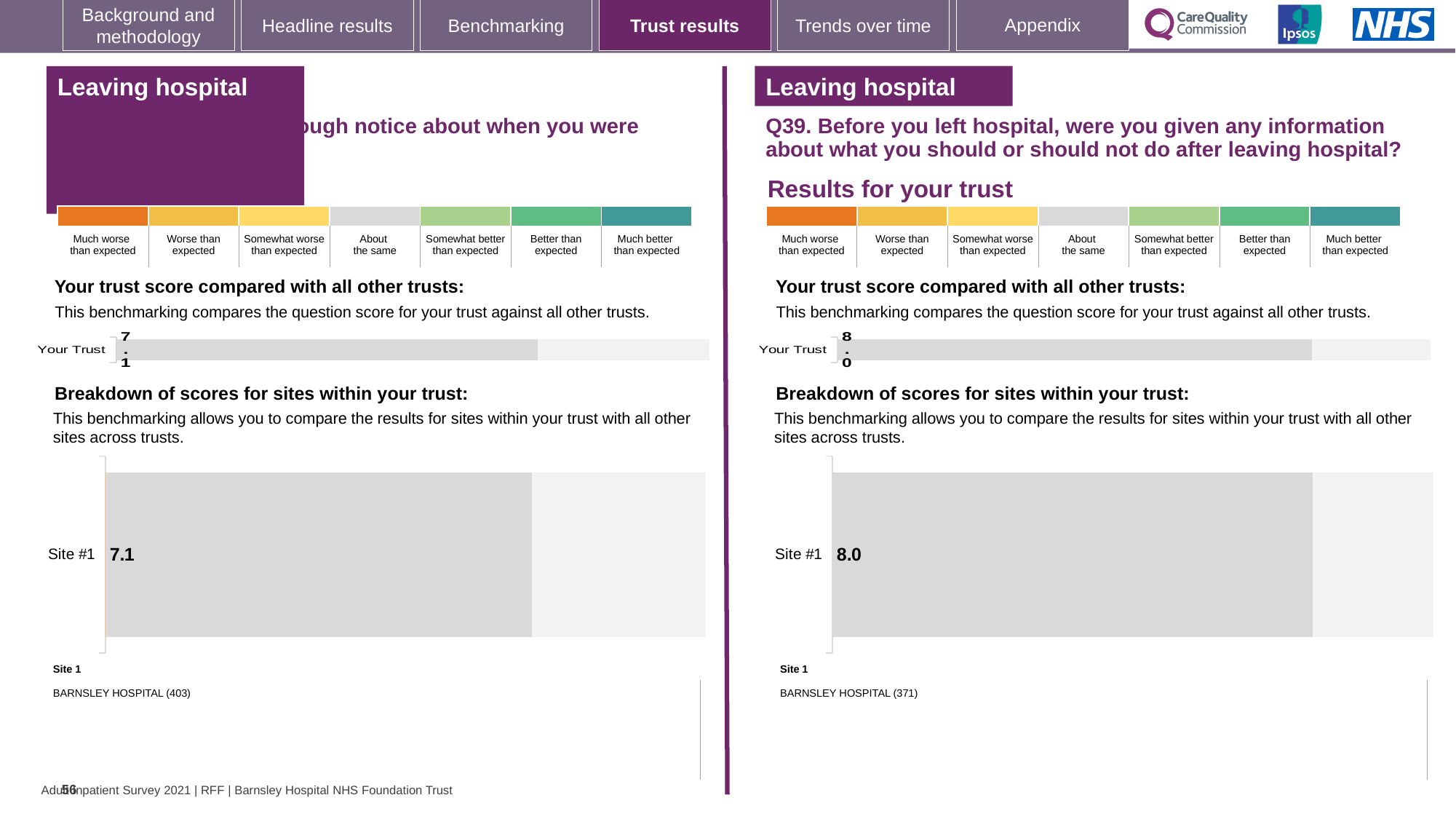
How many sites are plotted in the left-hand 'Breakdown of scores for sites within your trust' chart? 1 Which is larger: the Site #1 value in the left-hand site breakdown chart or the Site #1 value in the right-hand (Q39) site breakdown chart? Right-hand (Q39) Site #1 On the right half of the slide (Q39), in the 'Your trust score compared with all other trusts' chart, what is the value for Your Trust? 8.0 On the right half of the slide (Q39), in the 'Breakdown of scores for sites within your trust' chart, what is the value for Site #1? 8.0 Which hospital is listed as Site 1 beneath the right-hand (Q39) site breakdown chart? BARNSLEY HOSPITAL (371) How many sites are plotted in the right-hand (Q39) 'Breakdown of scores for sites within your trust' chart? 1 What kind of chart is used for the Site #1 score breakdown on the left half of the slide? Bar chart On the left half of the slide, in the 'Your trust score compared with all other trusts' chart, what is the value for Your Trust? 7.1 Which hospital is listed as Site 1 beneath the left-hand site breakdown chart? BARNSLEY HOSPITAL (403) What is the difference between the Your Trust value in the right-hand (Q39) trust score chart and the Your Trust value in the left-hand trust score chart? 0.9 On the left half of the slide, in the 'Breakdown of scores for sites within your trust' chart, what is the value for Site #1? 7.1 What kind of chart is used for the 'Your Trust' score on the right half of the slide (Q39)? Bar chart